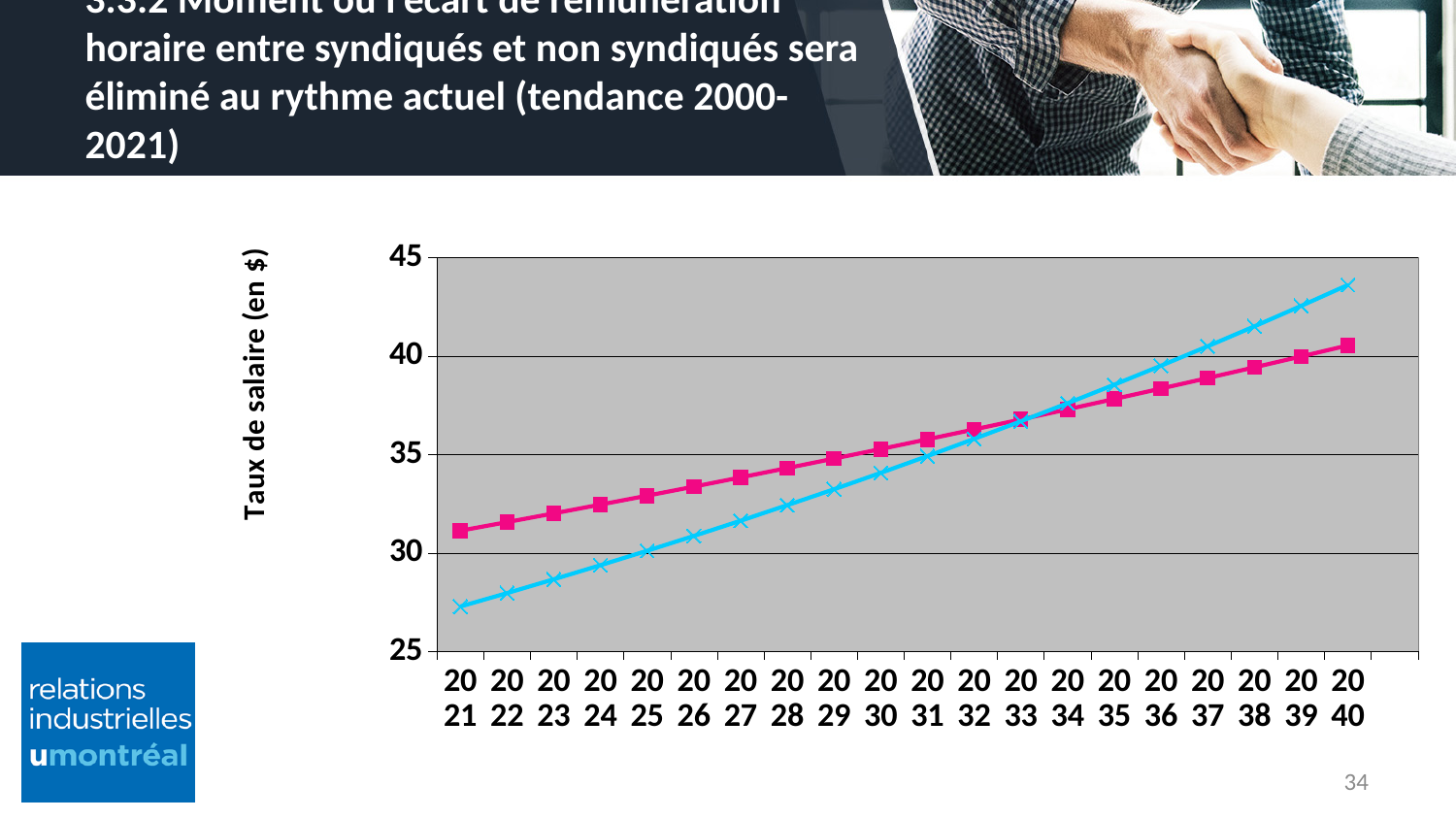
In 2021, which line has the higher value: the pink line with square markers or the blue line with x markers? the pink line with square markers Is the value of the pink line with square markers in 2021 greater or less than 30? greater Is the value of the blue line with x markers in 2040 greater or less than 40? greater How many lines are plotted on the chart? 2 Do the values of the blue line with x markers rise or fall from 2021 to 2040? rise Do the values of the pink line with square markers rise or fall from 2021 to 2040? rise In 2040, which line has the higher value: the pink line with square markers or the blue line with x markers? the blue line with x markers How many years are shown along the x axis of the chart? 20 What is the first year shown on the x axis of the chart? 2021 What kind of chart is shown on the slide? line chart What is the title of the y axis of the chart? Taux de salaire (en $) Is the value of the blue line with x markers in 2021 greater or less than 30? less